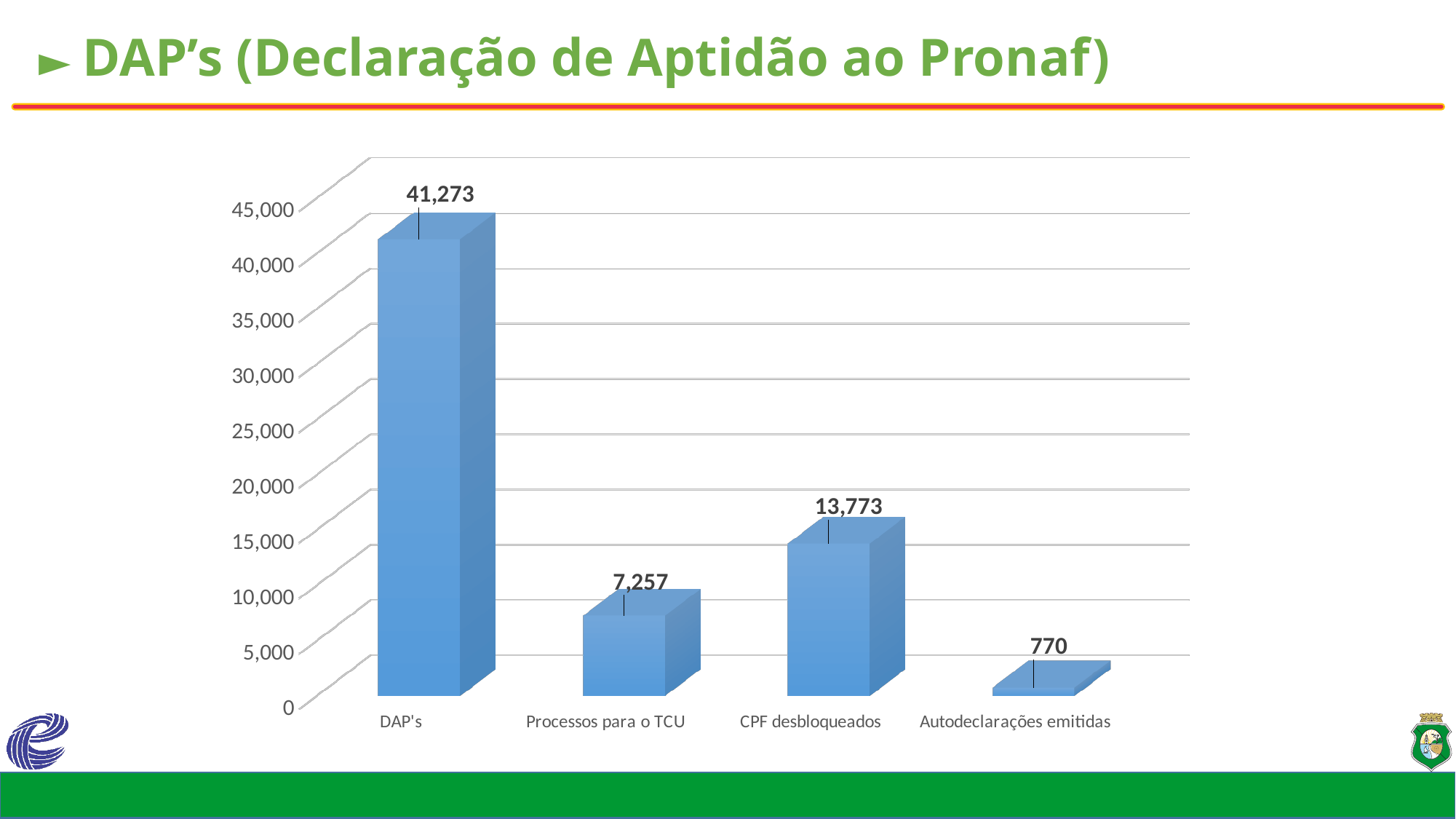
What is the value for DAP's? 41,273 How many categories are shown in the chart? 4 What is the difference between the values for DAP's and CPF desbloqueados? 27,500 Which category has the lowest value? Autodeclarações emitidas Which category has the highest value? DAP's Is the value for Processos para o TCU greater or less than 10,000? less What is the value for Processos para o TCU? 7,257 What is the value for Autodeclarações emitidas? 770 What kind of chart is shown on the slide? bar chart What is the value for CPF desbloqueados? 13,773 What is the difference between the values for CPF desbloqueados and Processos para o TCU? 6,516 Which is larger, the value for Processos para o TCU or the value for CPF desbloqueados? CPF desbloqueados